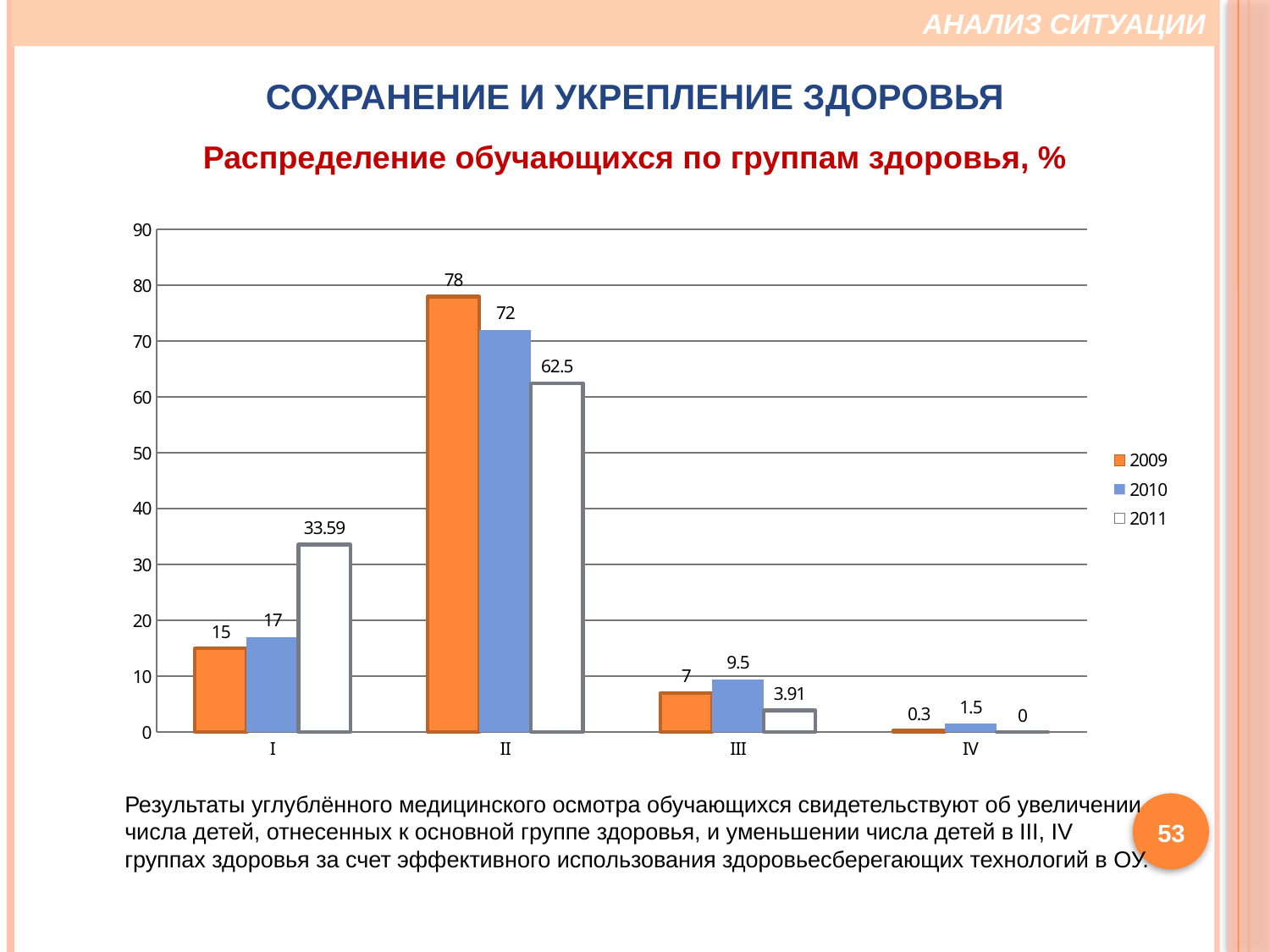
How many series does the legend list? 3 What is the value for group I in 2011? 33.59 What kind of chart is shown on the slide? bar chart How many health groups are shown on the x axis? 4 What is the value for group III in 2010? 9.5 Which is larger for group I: the 2010 value or the 2011 value? 2011 What is the difference between the 2009 and 2011 values for group II? 15.5 What is the value for group II in 2009? 78 Which health group has the lowest value in 2010? IV What is the value for group IV in 2009? 0.3 Which health group has the highest value in 2011? II Which year is shown in orange in the legend? 2009